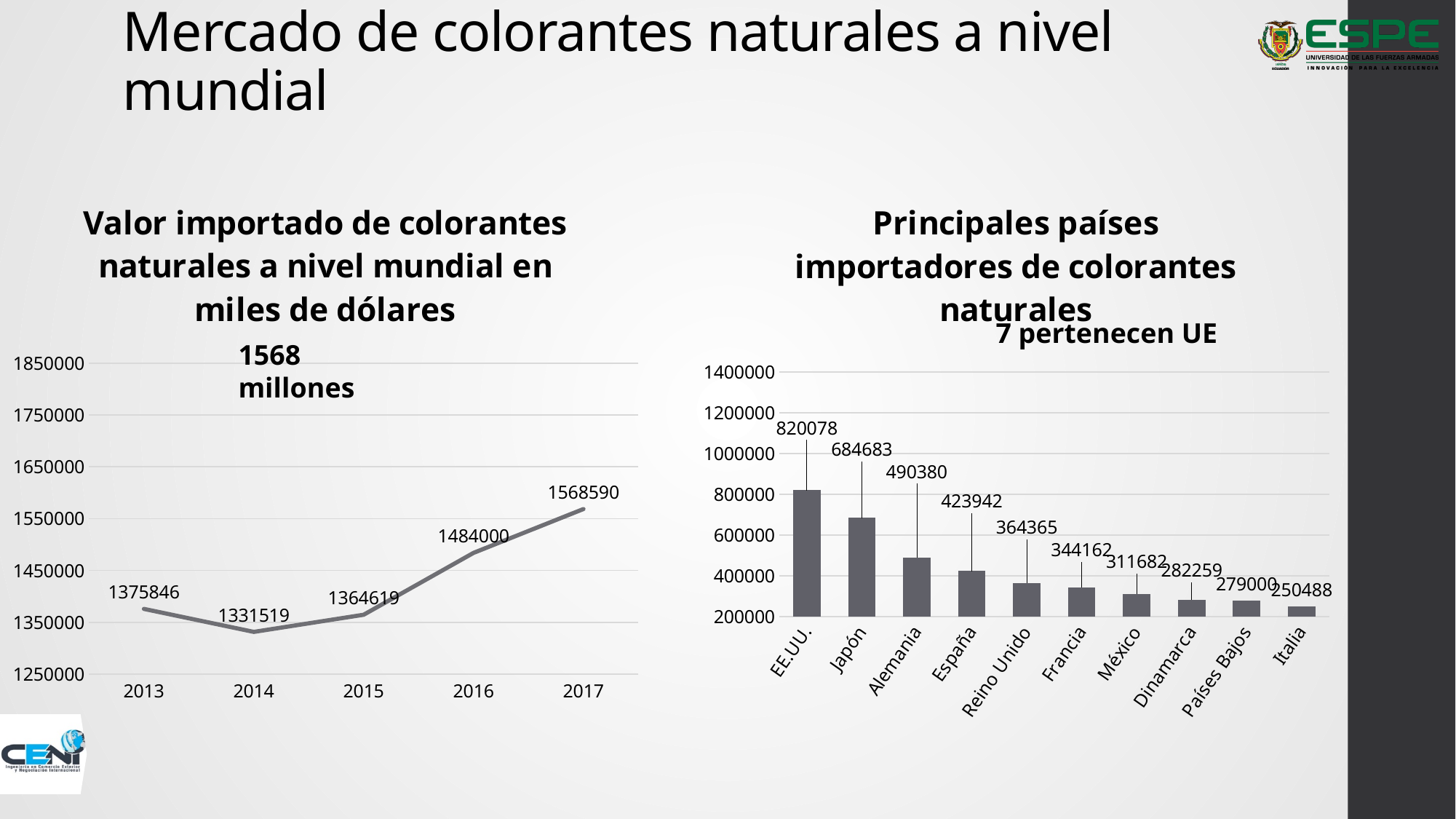
In the left chart (Valor importado de colorantes naturales), how many years are plotted? 5 In the left chart (Valor importado de colorantes naturales), what is the value for 2017? 1568590 In the left chart (Valor importado de colorantes naturales), what is the difference between the 2017 and 2016 values? 84590 In the right chart (Principales países importadores), how many countries are shown? 10 In the left chart (Valor importado de colorantes naturales), do the values rise or fall from 2015 to 2017? Rise In the right chart (Principales países importadores), which country has the lowest value? Italia In the right chart (Principales países importadores), what is the difference between the values for EE.UU. and Japón? 135395 In the left chart (Valor importado de colorantes naturales), what is the value for 2014? 1331519 In the left chart (Valor importado de colorantes naturales), which year has the lowest value? 2014 In the right chart (Principales países importadores), which country has the highest value? EE.UU. What kind of chart is the left chart (Valor importado de colorantes naturales)? Line chart In the right chart (Principales países importadores), what is the value for Alemania? 490380